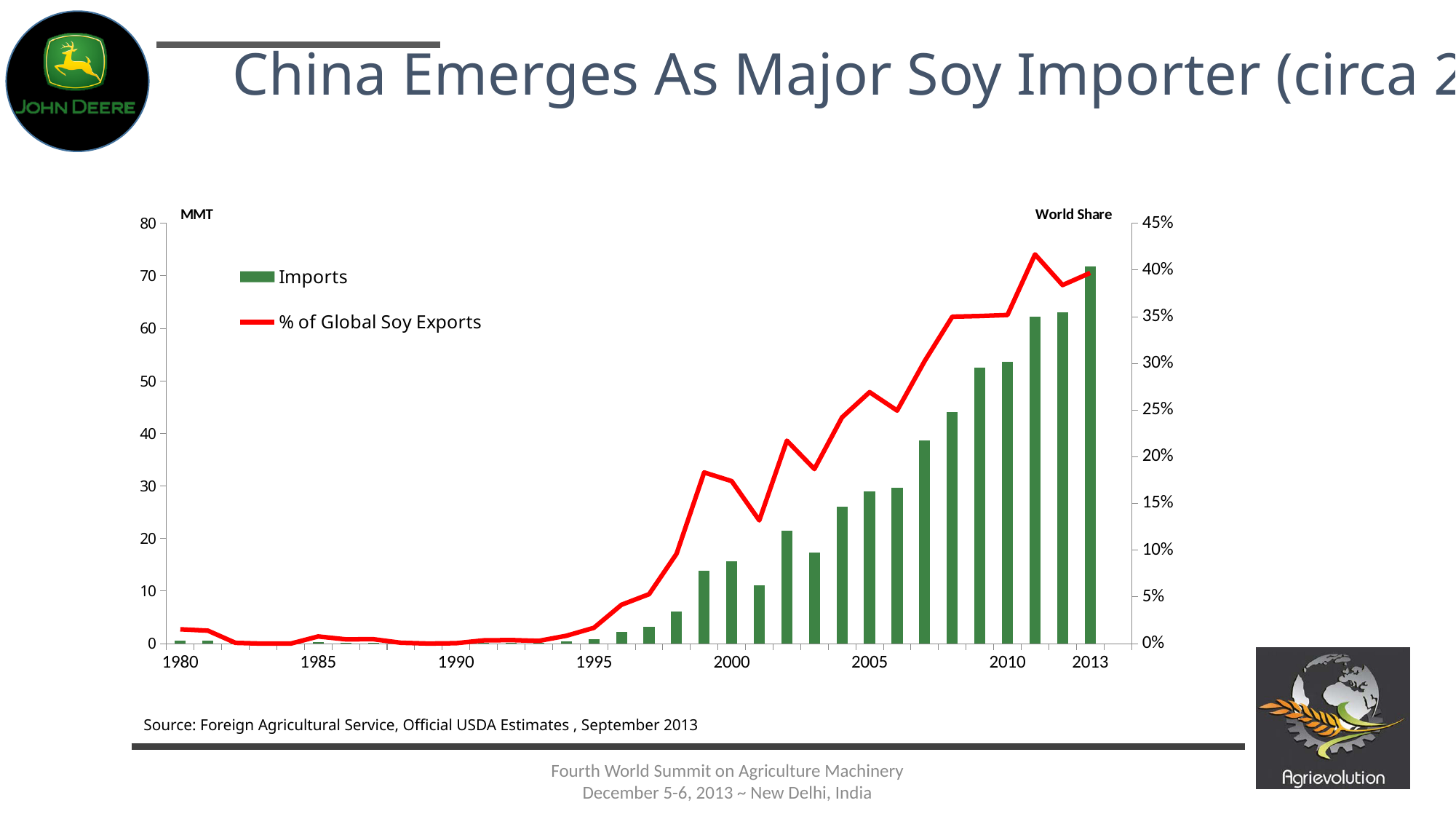
Is the % of Global Soy Exports value for 2001 greater or less than 15%? less How many series does the legend list? 2 In which year is the Imports bar the highest? 2013 Which is larger, the Imports value for 2005 or the Imports value for 2010? 2010 Which series is drawn as a red line? % of Global Soy Exports Is the Imports value for 2010 greater or less than 50? greater Do the Imports bars generally rise or fall from 1995 to 2013? Rise What kind of chart is shown on the slide? A combined bar and line chart Is the % of Global Soy Exports value for 2011 greater or less than 40%? greater What unit label appears at the top of the left axis? MMT